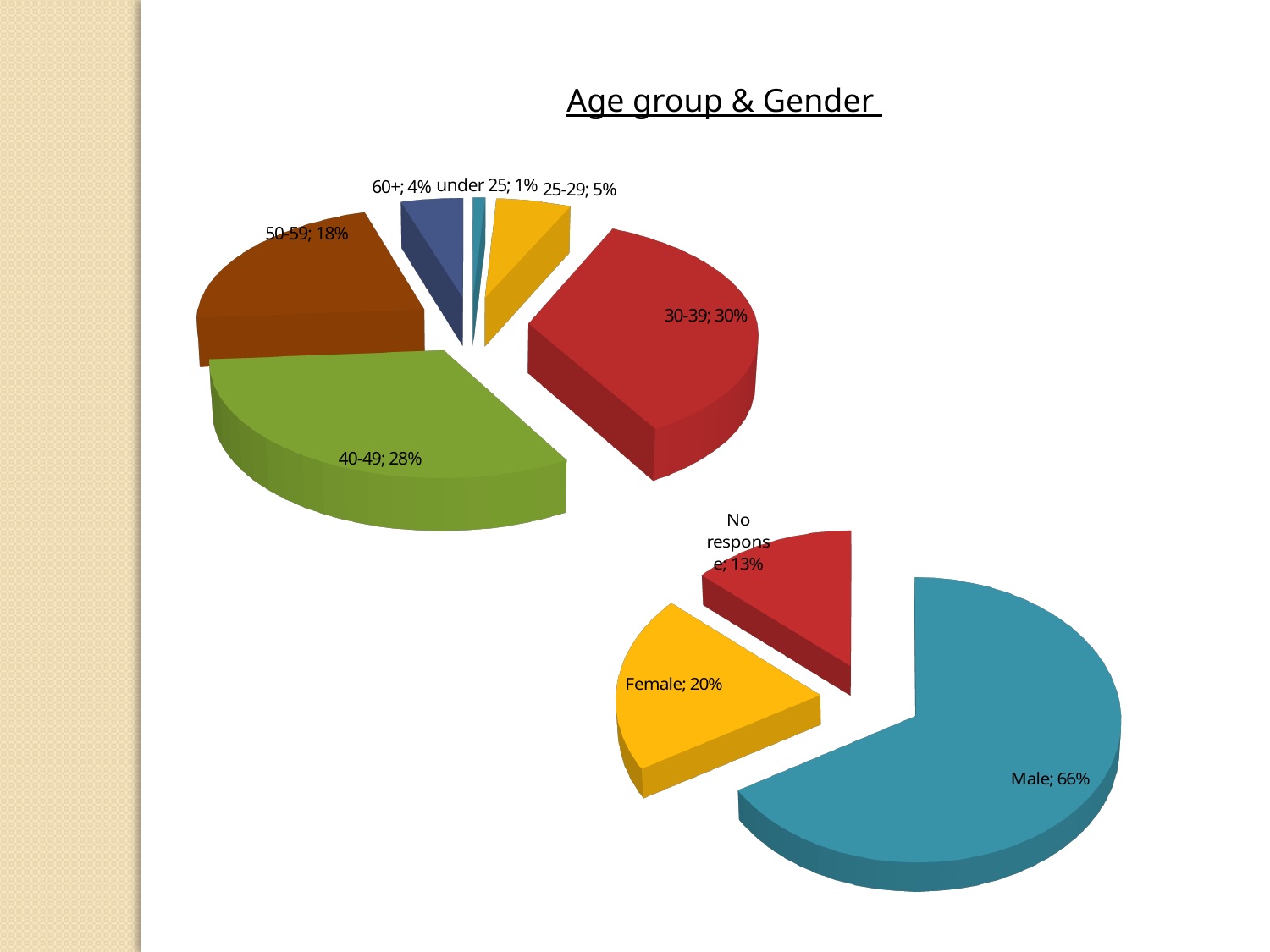
In the age group pie chart (upper left), which is larger, the share for 25-29 or the share for 60+? 25-29 In the gender pie chart (lower right), what percentage is shown for Female? 20% In the gender pie chart (lower right), what percentage is shown for No response? 13% In the gender pie chart (lower right), which category has the largest share? Male In the gender pie chart (lower right), what is the difference in percentage points between Male and Female? 46 In the age group pie chart (upper left), which age group has the smallest share? under 25 How many slices does the age group pie chart (upper left) have? 6 In the age group pie chart (upper left), what percentage is shown for the 30-39 age group? 30% What type of chart is used for the gender data (lower right)? Pie chart In the age group pie chart (upper left), what is the difference in percentage points between the 40-49 and 50-59 groups? 10 In the age group pie chart (upper left), which age group has the largest share? 30-39 In the age group pie chart (upper left), what percentage is shown for the 50-59 age group? 18%